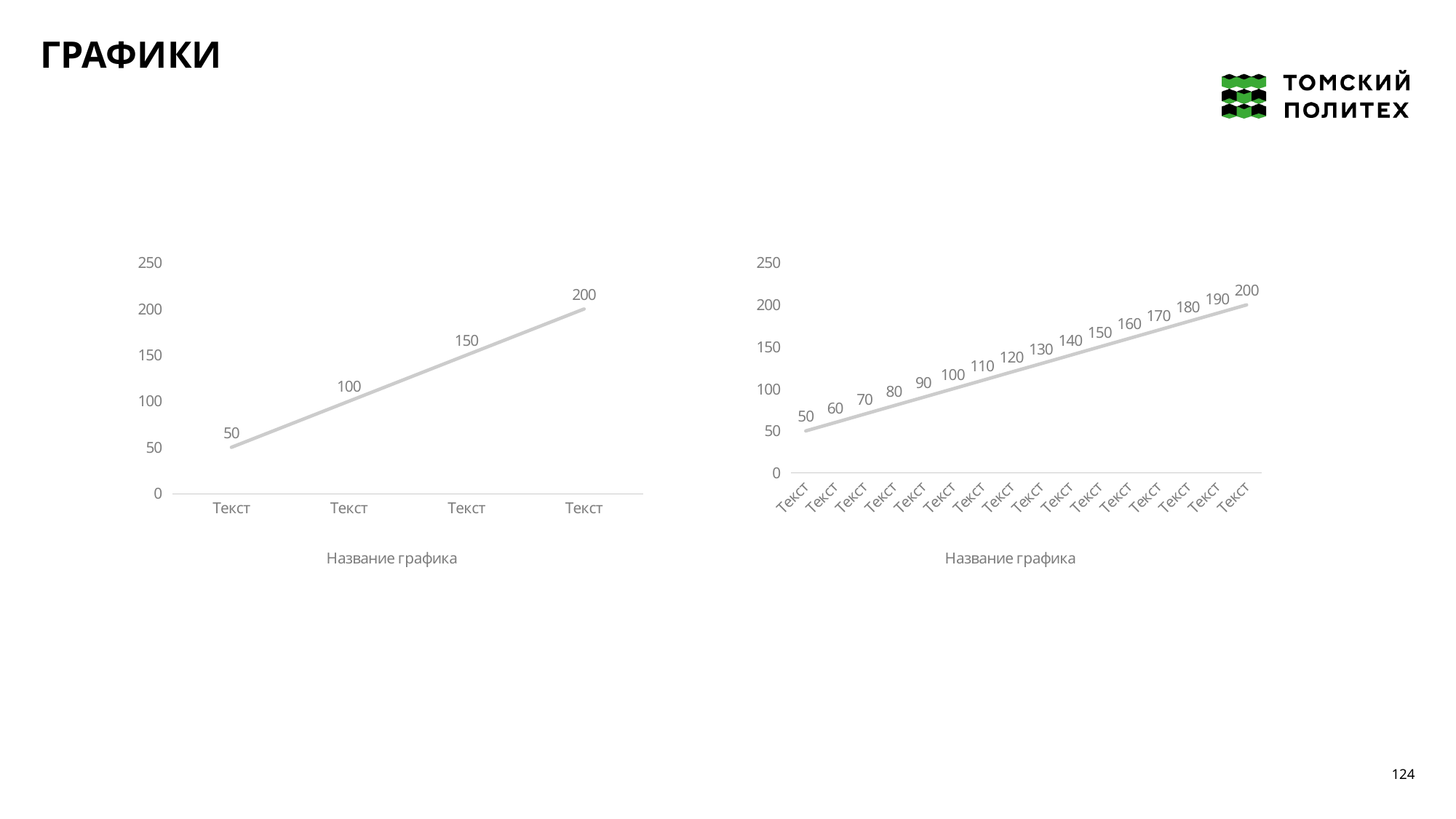
On the left chart, what is the difference between the last and the first data point? 150 How many data points are plotted on the right chart? 16 On the right chart, what is the lowest plotted value? 50 What is the title shown below the left chart? Название графика On the left chart, what is the value of the last data point? 200 What kind of chart is the left chart? line chart How many data points are plotted on the left chart? 4 On the right chart, what is the difference between the second data point (60) and the first data point (50)? 10 Do the values on the right chart rise or fall from left to right along the x axis? rise On the left chart, what is the value of the first data point? 50 What kind of chart is the right chart? line chart On the left chart, what is the highest plotted value? 200